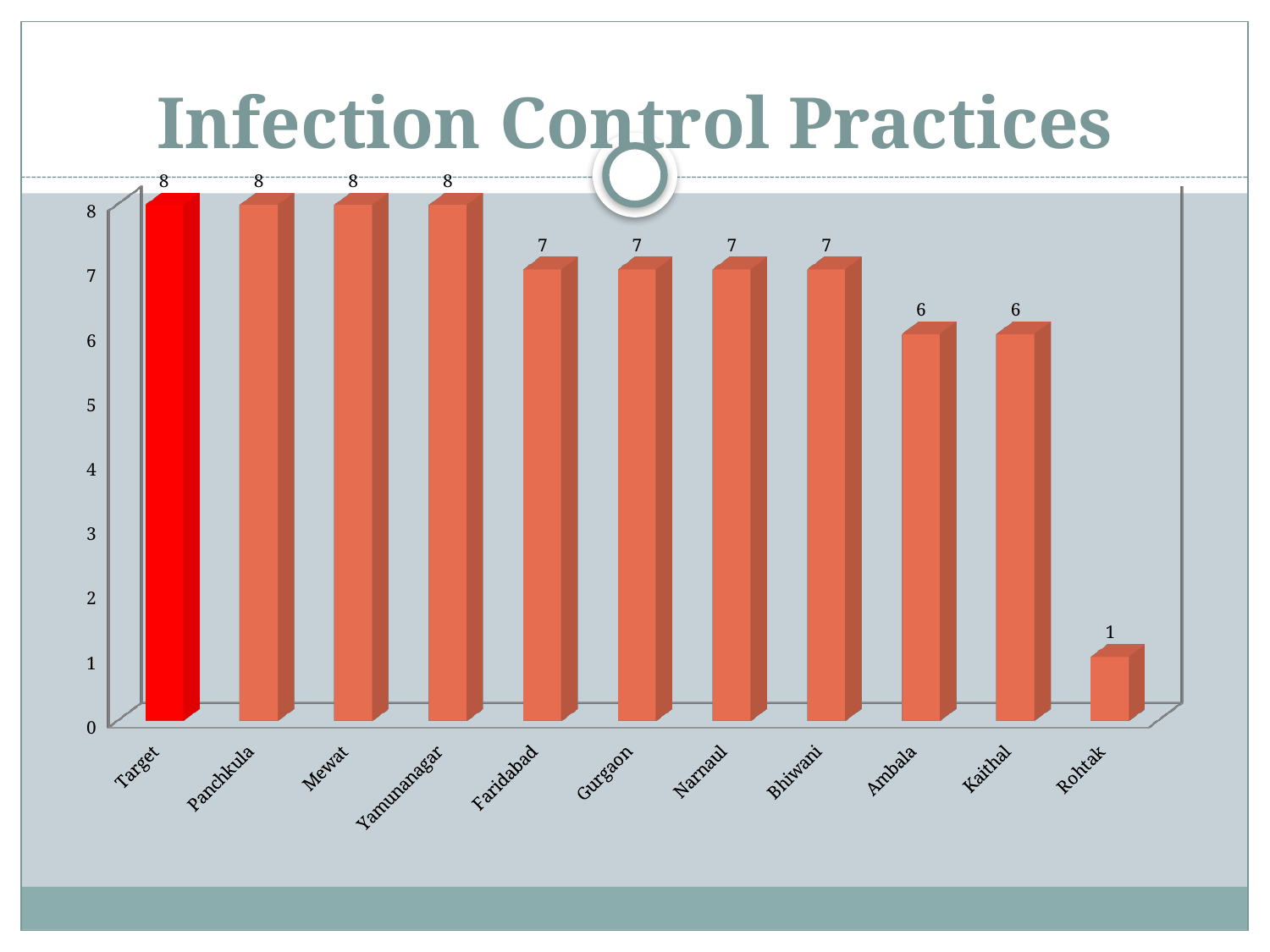
What kind of chart is shown on the slide? bar chart Which category has the lowest value? Rohtak How many categories are shown on the x axis? 11 What is the title of the chart? Infection Control Practices What is the value for Rohtak? 1 What is the difference between the values for Panchkula and Kaithal? 2 What is the value for Target? 8 What is the value for Faridabad? 7 What is the value for Ambala? 6 Which is larger, the value for Gurgaon or the value for Kaithal? Gurgaon Is the value for Bhiwani greater or less than 5? greater What is the difference between the values for Target and Rohtak? 7